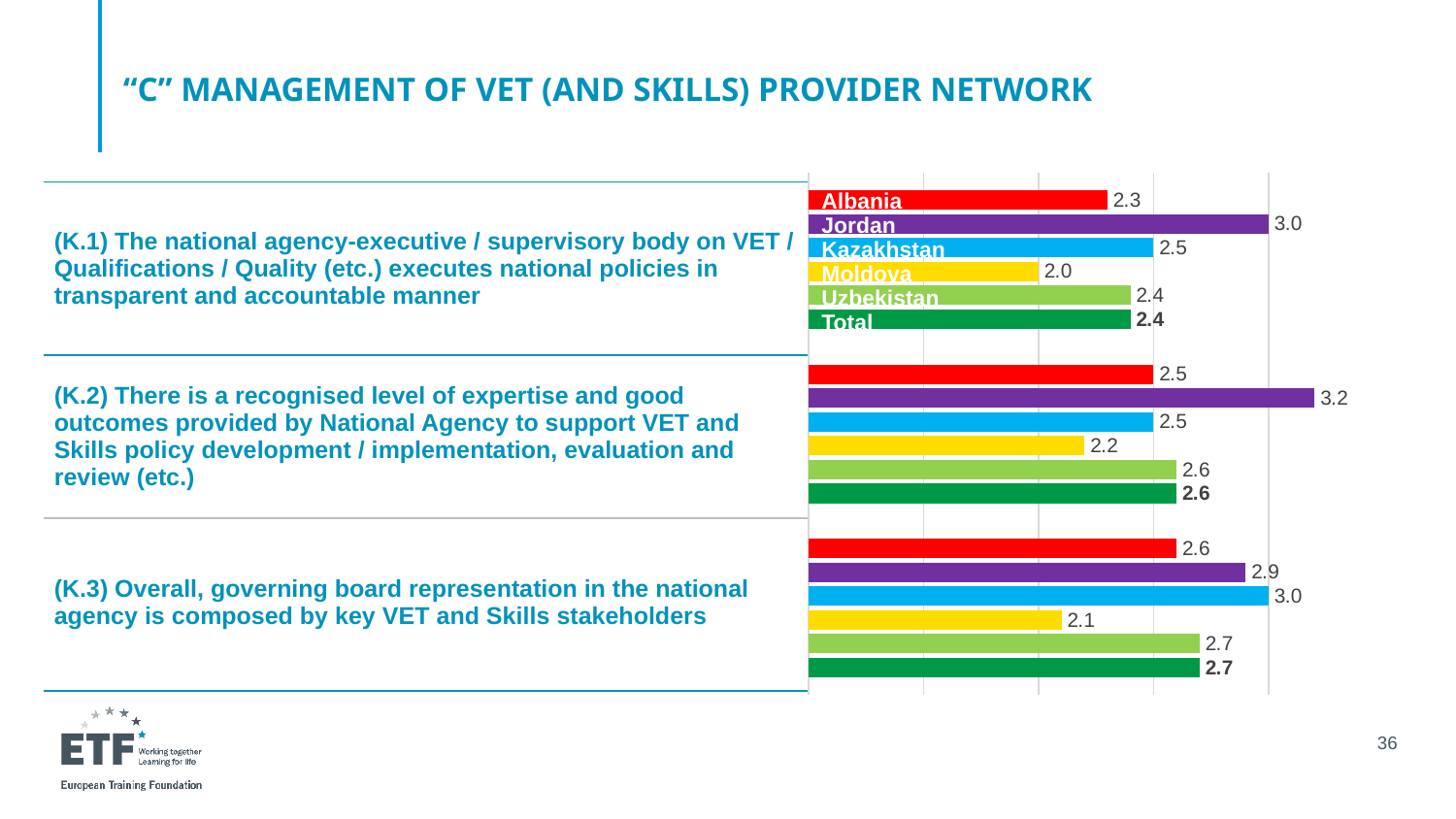
How many countries (excluding Total) are shown for each statement? 5 What is the value for Jordan on statement K.1? 3.0 What is the value for Moldova on statement K.1? 2.0 What colour are the bars for Jordan? purple What is the Total value for statement K.2? 2.6 What is the value for Kazakhstan on statement K.3? 3.0 On statement K.3, which is larger: the value for Kazakhstan or the value for Jordan? Kazakhstan Which country has the lowest value on statement K.3? Moldova How many statements (K.1, K.2, K.3) are plotted in the chart? 3 What is the difference between Jordan's and Moldova's values on statement K.1? 1.0 Which country has the highest value on statement K.2? Jordan What kind of chart is shown on the slide? bar chart